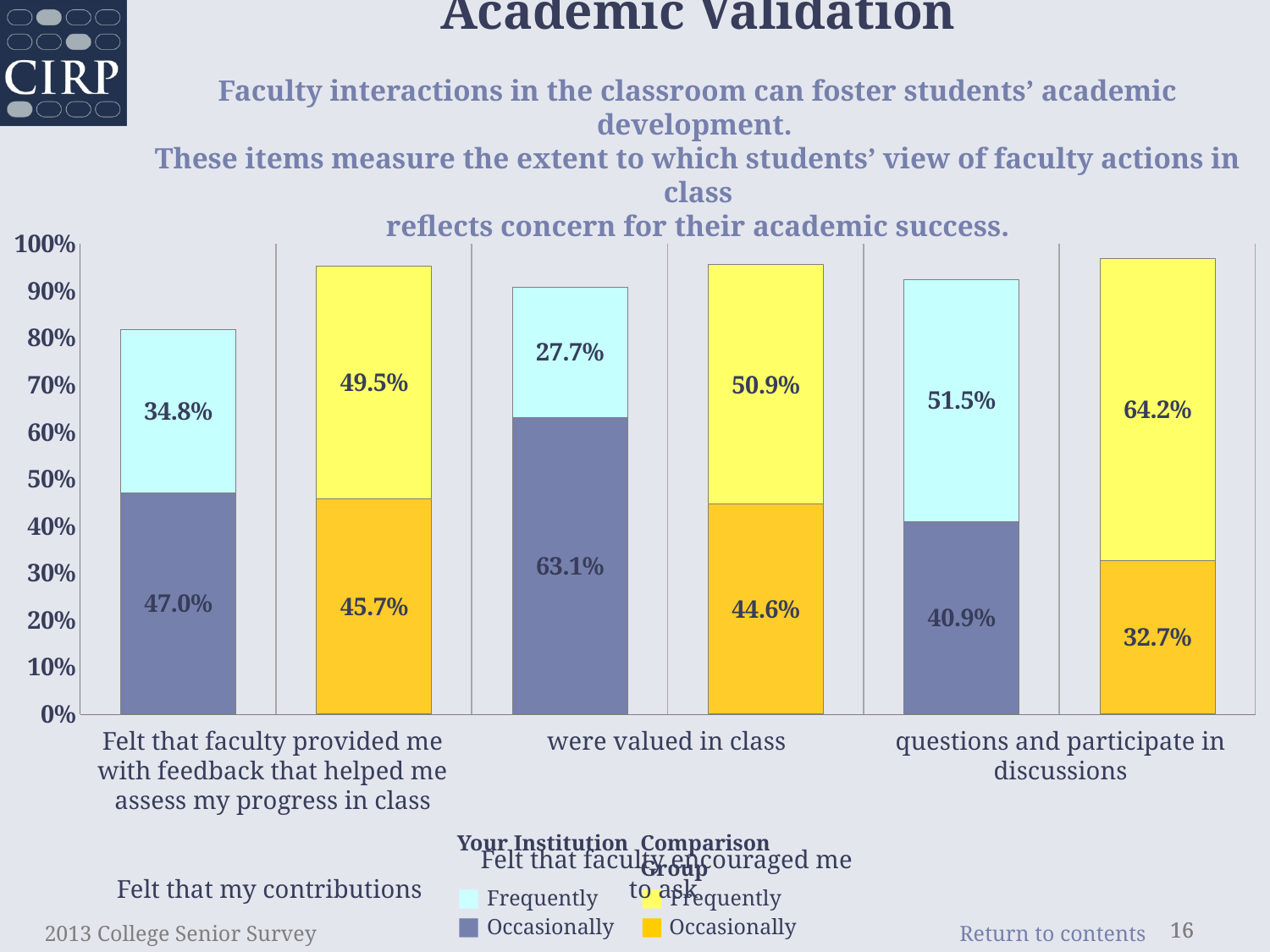
What is the total height of the Your Institution stacked bar for feeling that faculty provided feedback that helped assess progress in class? 81.8% What is the Your Institution 'Occasionally' value for feeling that their contributions were valued in class? 63.1% What is the Comparison Group 'Occasionally' value for feeling that faculty encouraged them to ask questions and participate in discussions? 32.7% What is the difference between the Comparison Group and Your Institution 'Frequently' values for feeling that contributions were valued in class? 23.2% Which item has the lowest Your Institution 'Frequently' value? Felt that my contributions were valued in class For feeling that faculty encouraged asking questions and participating in discussions, which is larger: the Your Institution 'Frequently' value or the Comparison Group 'Frequently' value? Comparison Group 'Frequently' (64.2%) What type of chart is shown on the slide? Stacked bar chart How many series does the chart legend list? 4 What percentage of Your Institution students reported 'Frequently' for feeling that faculty provided feedback that helped them assess their progress in class? 34.8% What is the total height of the Comparison Group stacked bar for feeling that faculty encouraged asking questions and participating in discussions? 96.9% How many survey items (categories) are shown on the x axis of the chart? 3 Which item has the highest Comparison Group 'Frequently' value? Felt that faculty encouraged me to ask questions and participate in discussions